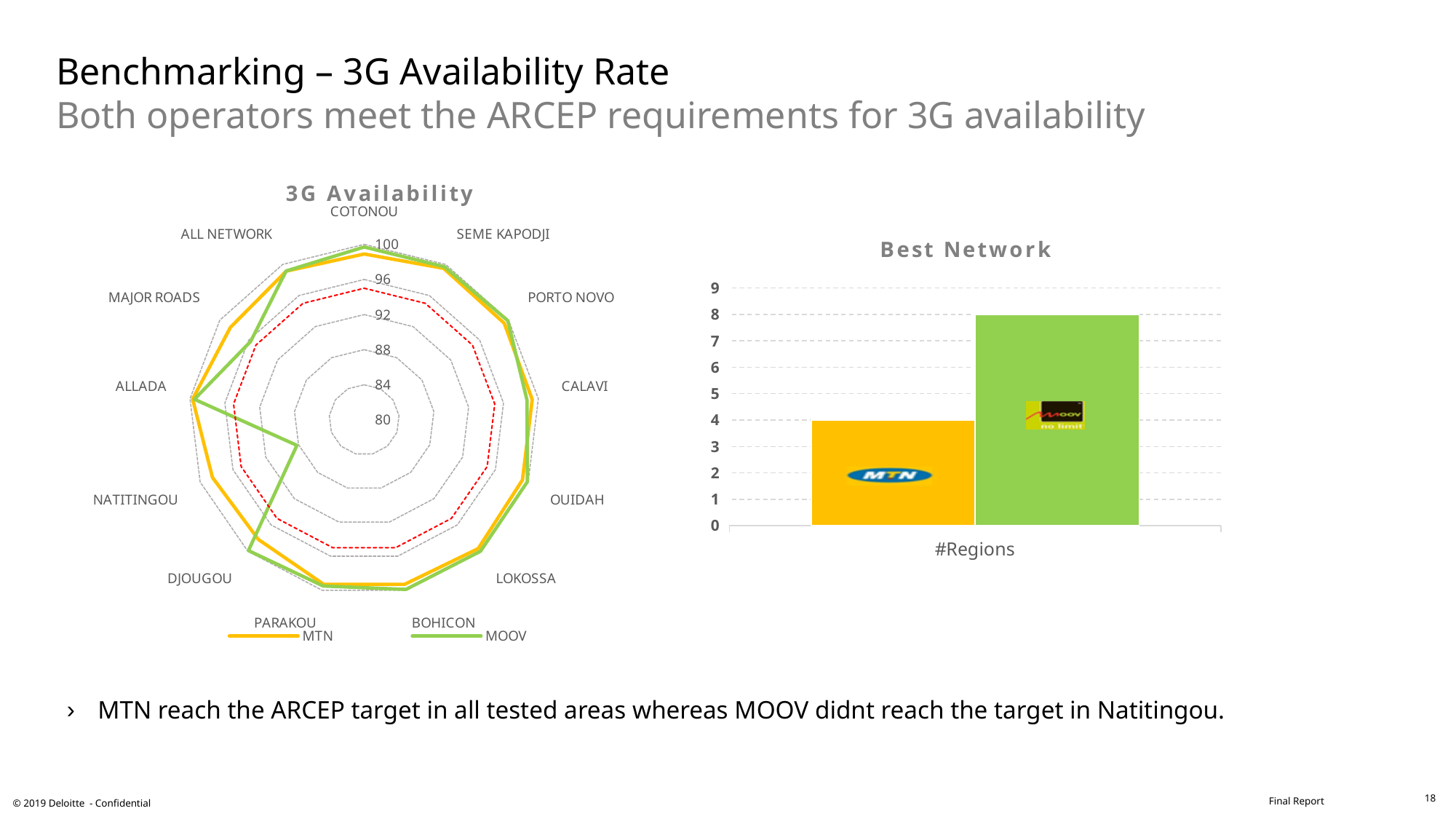
In the 3G Availability chart, which operator has the lower value at NATITINGOU? MOOV In the Best Network chart, what is the value for MOOV? 8 In the Best Network chart, what is the value for MTN? 4 In the Best Network chart, what is the difference between the MOOV and MTN values? 4 How many series does the legend of the 3G Availability chart list? 2 In the 3G Availability chart, which colour represents MTN? yellow What kind of chart is the 3G Availability chart? radar chart How many categories are plotted on the 3G Availability radar chart? 13 In the 3G Availability chart, is the MOOV value for NATITINGOU greater or less than 92? less In the Best Network chart, which operator has the higher number of regions? MOOV In the 3G Availability chart, is the MTN value for NATITINGOU greater or less than 96? greater What kind of chart is the Best Network chart? bar chart